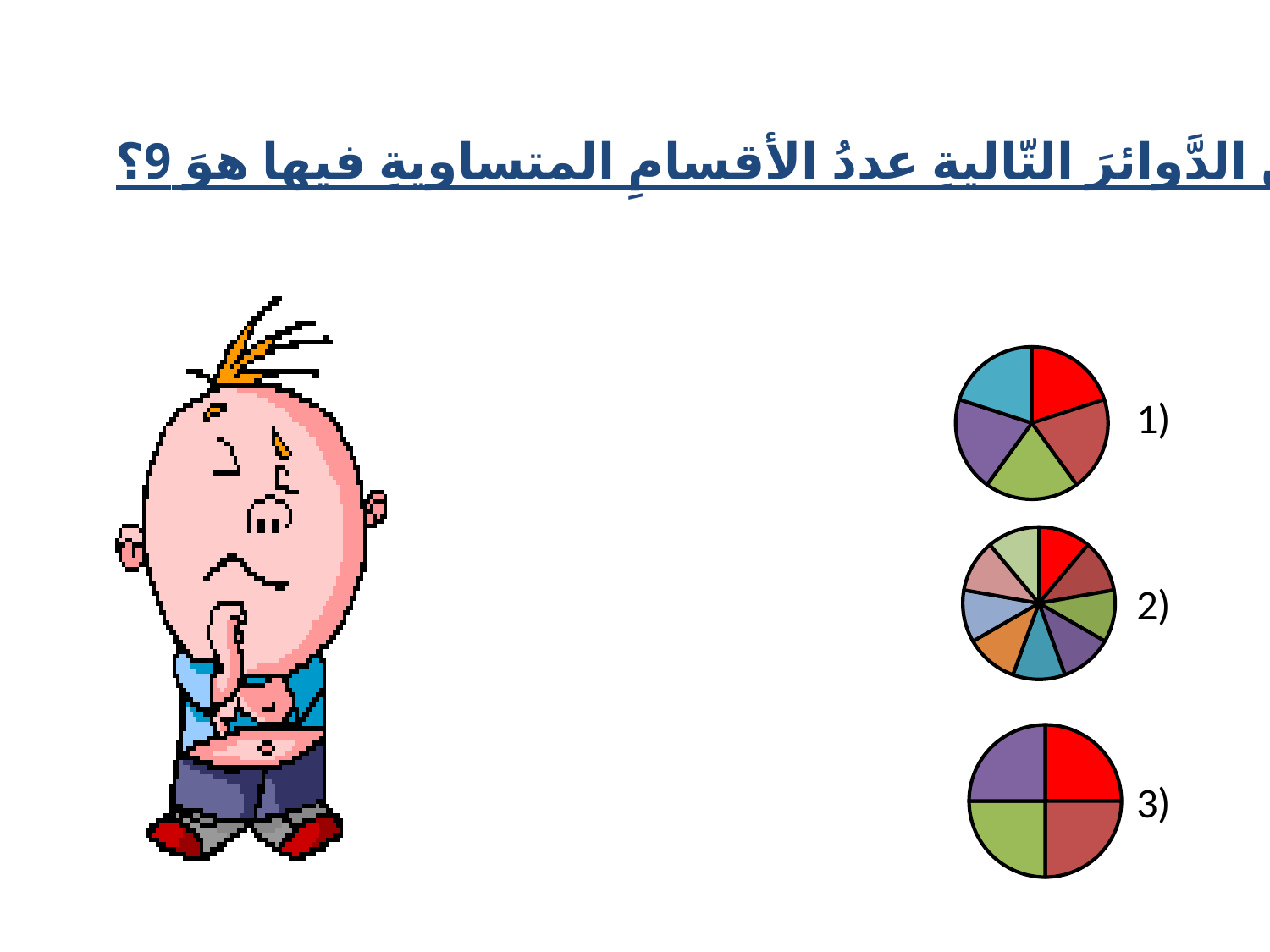
How many equal parts is the circle labelled 3) divided into? 4 What kind of chart is the circle labelled 1)? pie chart What kind of chart is the circle labelled 3)? pie chart Which circle has more parts, the one labelled 1) or the one labelled 3)? 1) What colour is the top-right part of the circle labelled 3)? red Are the parts of the circle labelled 3) equal in size? yes Which of the circles on the slide is divided into 9 equal parts? 2) How many equal parts is the circle labelled 1) divided into? 5 Which circle is divided into the fewest parts? 3) Which circle is divided into the most parts? 2)